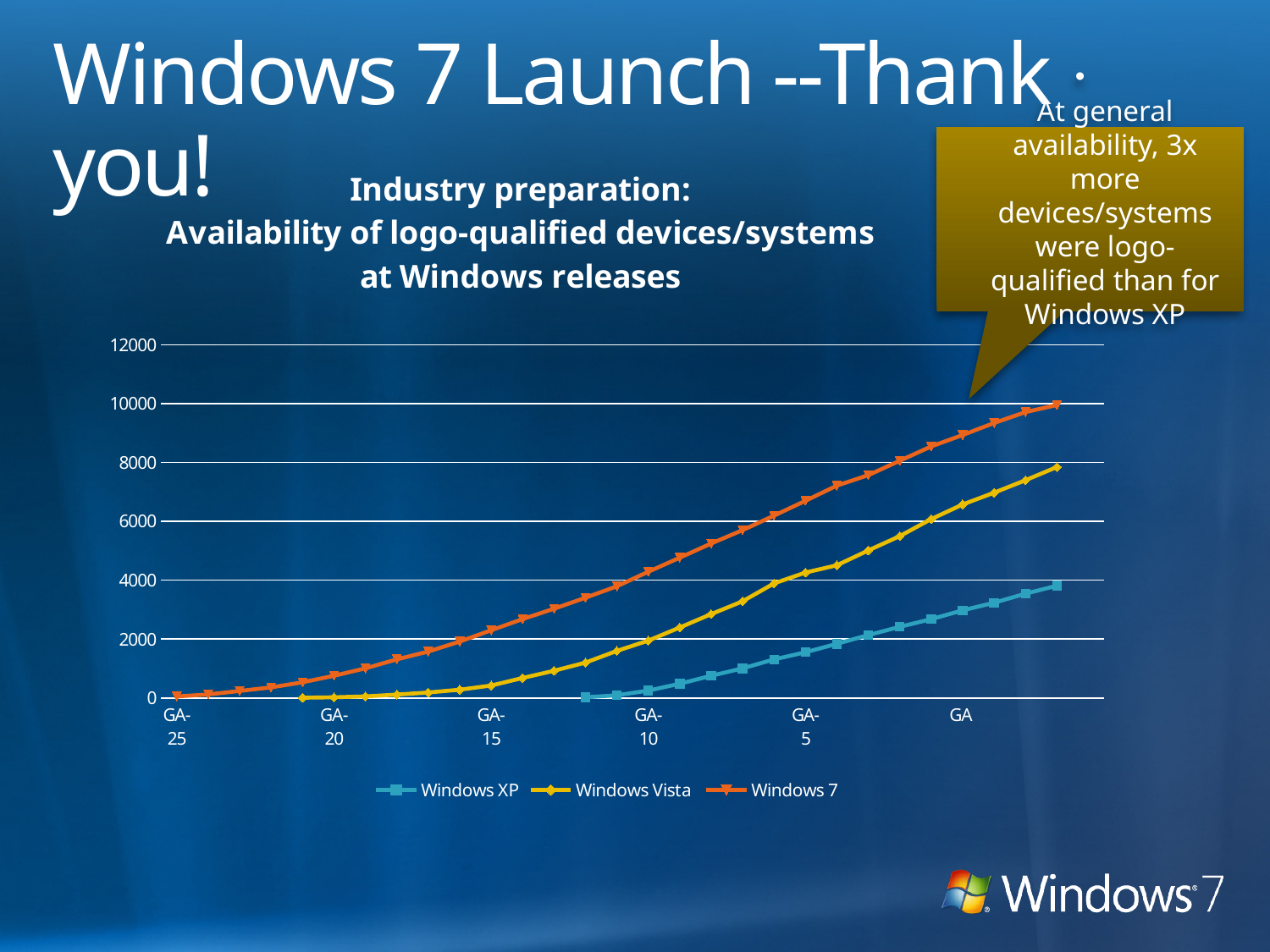
Is the value for Windows 7 at GA greater or less than 8000? greater What kind of chart is shown on the slide? line chart How many series does the legend list? 3 Is the value for Windows Vista at GA greater or less than 6000? greater Which series are listed in the chart legend? Windows XP, Windows Vista, Windows 7 What is the title of the chart? Industry preparation: Availability of logo-qualified devices/systems at Windows releases Which series has the highest value at GA? Windows 7 At GA-5, which is larger: the value for Windows Vista or the value for Windows XP? Windows Vista Which series has the lowest value at GA? Windows XP Do the values for Windows 7 rise or fall from GA-25 to GA? rise Is the value for Windows XP at GA greater or less than 4000? less